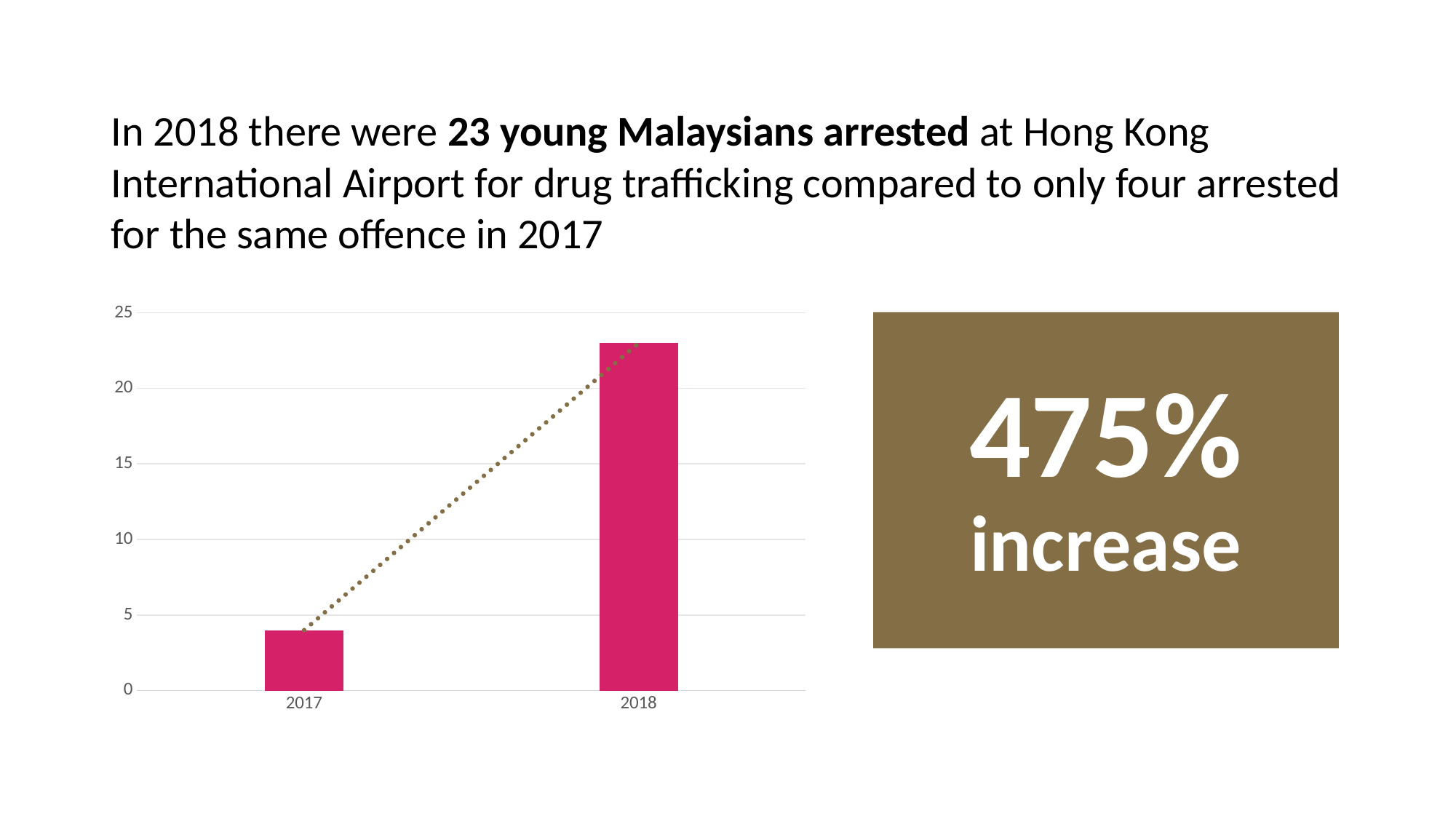
What percentage increase is shown in the box next to the chart? 475% How many categories (years) are plotted on the chart? 2 What kind of chart is shown on the slide? bar chart According to the slide, how many were arrested for the same offence in 2017? four Is the value for 2018 greater or less than 25? less According to the slide, how many young Malaysians were arrested at Hong Kong International Airport in 2018? 23 Which year has the higher bar on the chart? 2018 Do the values rise or fall from 2017 to 2018? rise By how much did the number of arrests increase from 2017 to 2018? 19 Which year has the lower bar on the chart? 2017 Is the value for 2018 greater or less than 20? greater Is the value for 2017 greater or less than 5? less